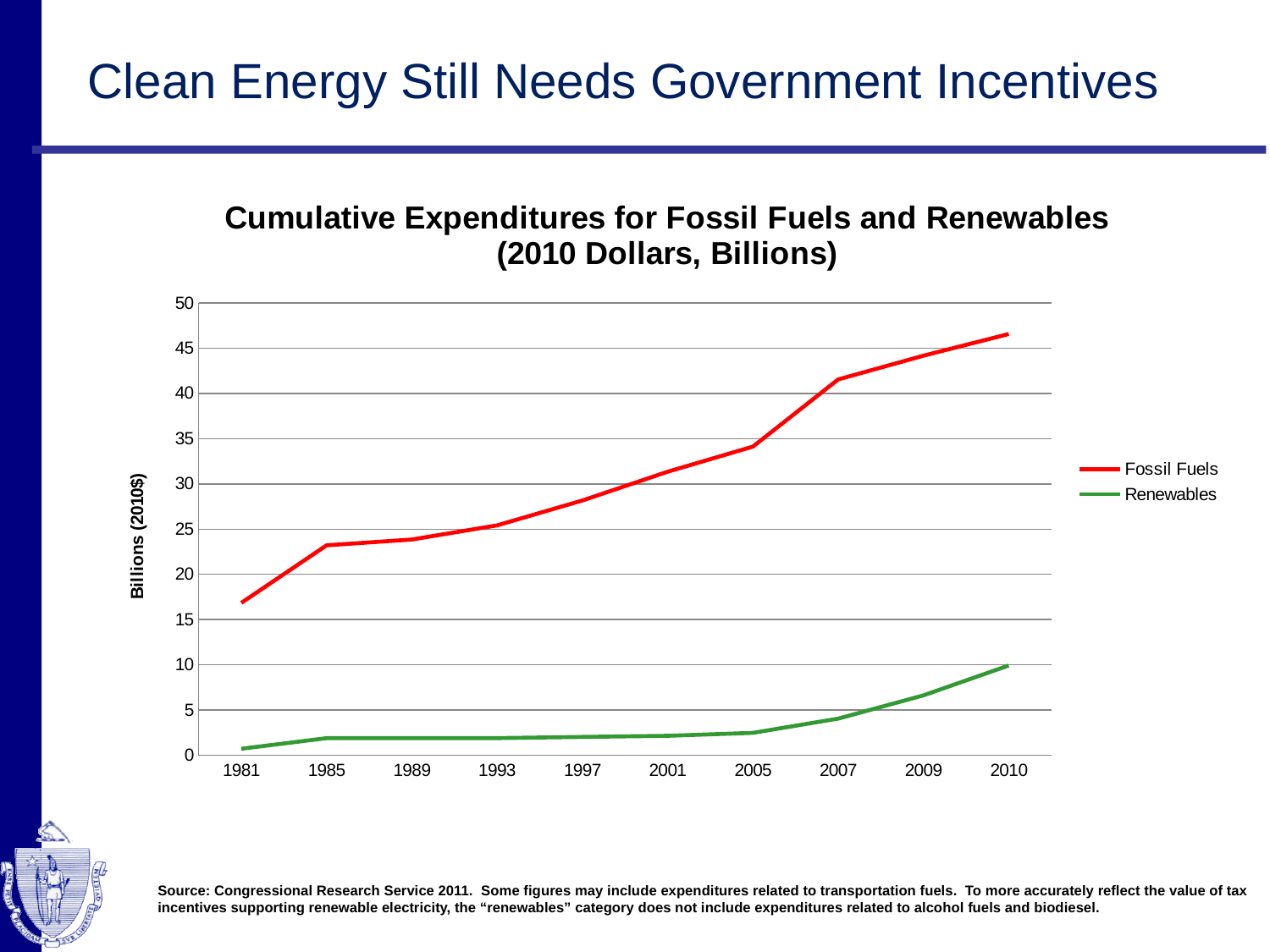
In which year is the Renewables value lowest? 1981 Is the Renewables value for 2005 greater or less than 5? less Is the Fossil Fuels value for 1981 greater or less than 20? less What is the title of the chart? Cumulative Expenditures for Fossil Fuels and Renewables (2010 Dollars, Billions) In 2010, which series has the larger value, Fossil Fuels or Renewables? Fossil Fuels Do the Fossil Fuels values rise or fall from 1981 to 2010? rise Is the Fossil Fuels value for 2010 greater or less than 45? greater In which year is the Fossil Fuels value highest? 2010 Which series is shown in red? Fossil Fuels How many years are marked along the x axis? 10 What kind of chart is shown on the slide? line chart How many series does the legend list? 2